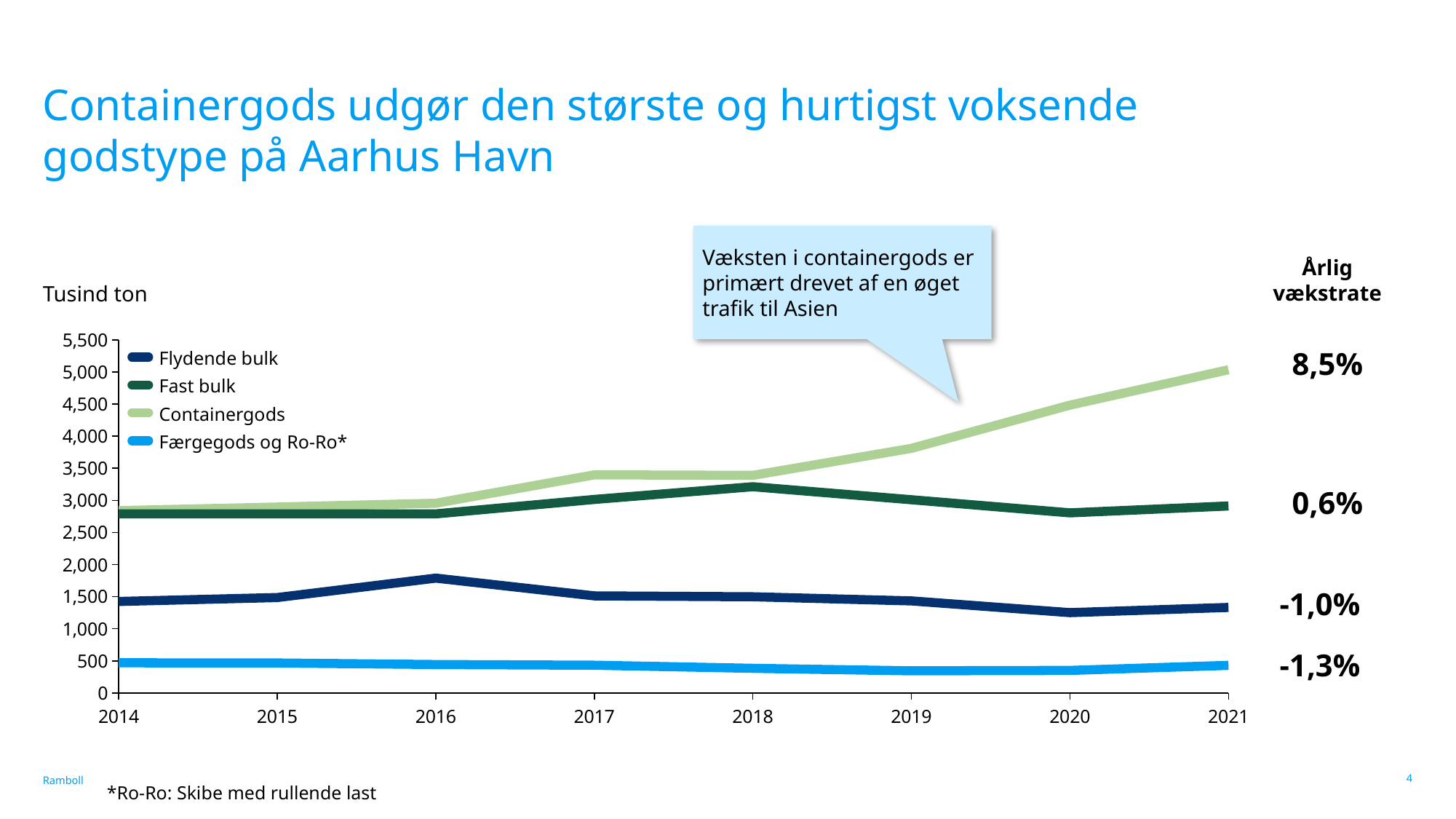
What unit is given for the y axis? Tusind ton What kind of chart is shown on the slide? Line chart Is the value for Færgegods og Ro-Ro* in 2014 greater or less than 1,000? less In 2018, which is larger: Fast bulk or Flydende bulk? Fast bulk How many series does the legend list? 4 Is the value for Flydende bulk in 2016 greater or less than 1,500? greater Which series has the lowest value in 2021? Færgegods og Ro-Ro* Does the Containergods line rise or fall from 2014 to 2021? Rises How many years are shown on the x axis? 8 Which series has the highest value in 2021? Containergods Is the value for Containergods in 2021 greater or less than 4,500? greater What annual growth rate (Årlig vækstrate) is shown for Containergods? 8,5%